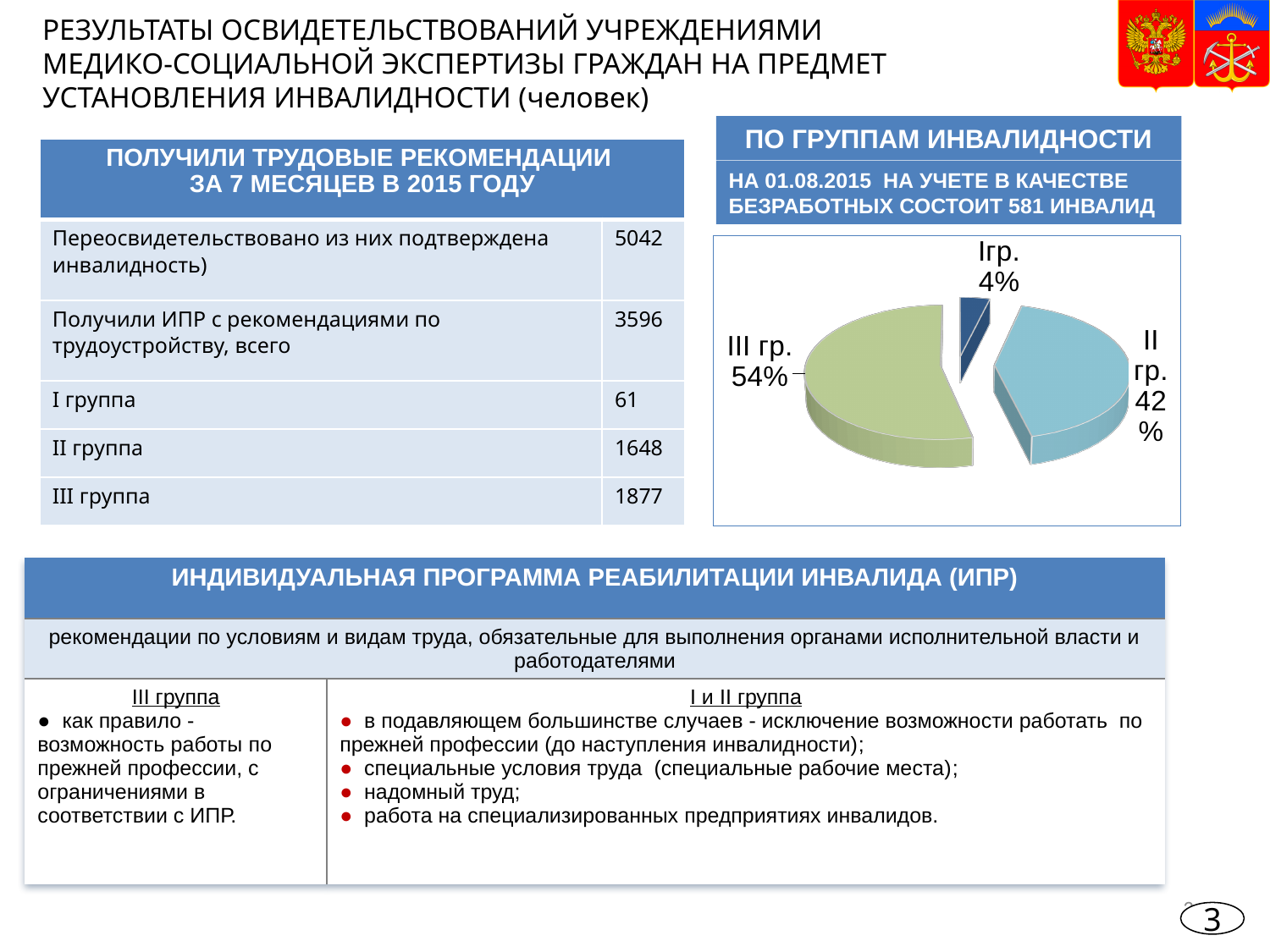
What is the heading above the pie chart? ПО ГРУППАМ ИНВАЛИДНОСТИ What share of the pie chart does Iгр. have? 4% Which group has the largest slice in the pie chart? III гр. In the pie chart, what is the difference in percentage points between II гр. and Iгр.? 38 In the pie chart, which is larger: the share for II гр. or the share for III гр.? III гр. What kind of chart is shown under the heading "ПО ГРУППАМ ИНВАЛИДНОСТИ"? pie chart In the pie chart, what is the difference in percentage points between III гр. and II гр.? 12 Which group has the smallest slice in the pie chart? Iгр. What share of the pie chart does III гр. have? 54% What share of the pie chart does II гр. have? 42% How many slices does the pie chart have? 3 In the pie chart, is the share for III гр. greater or less than 50%? greater